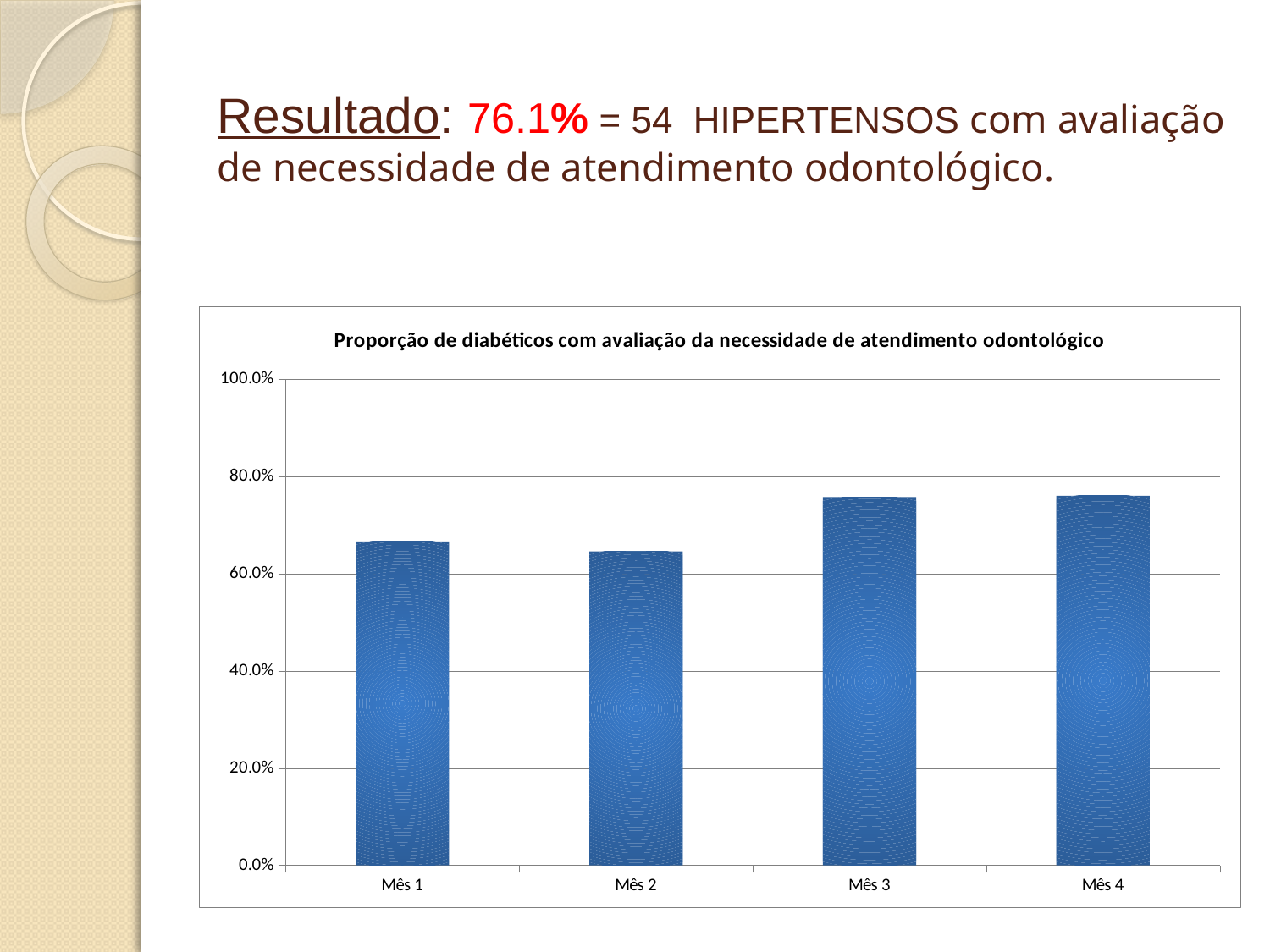
What kind of chart is shown on the slide? bar chart Which is larger, the value for Mês 4 or the value for Mês 2? Mês 4 What is the title of the chart? Proporção de diabéticos com avaliação da necessidade de atendimento odontológico Is the value for Mês 4 greater or less than 80.0%? less Is the value for Mês 3 greater or less than 80.0%? less Which is larger, the value for Mês 3 or the value for Mês 1? Mês 3 Which month has the lowest value? Mês 2 Is the value for Mês 2 greater or less than 60.0%? greater What is the highest value shown on the y axis? 100.0% How many categories (months) are plotted on the x axis? 4